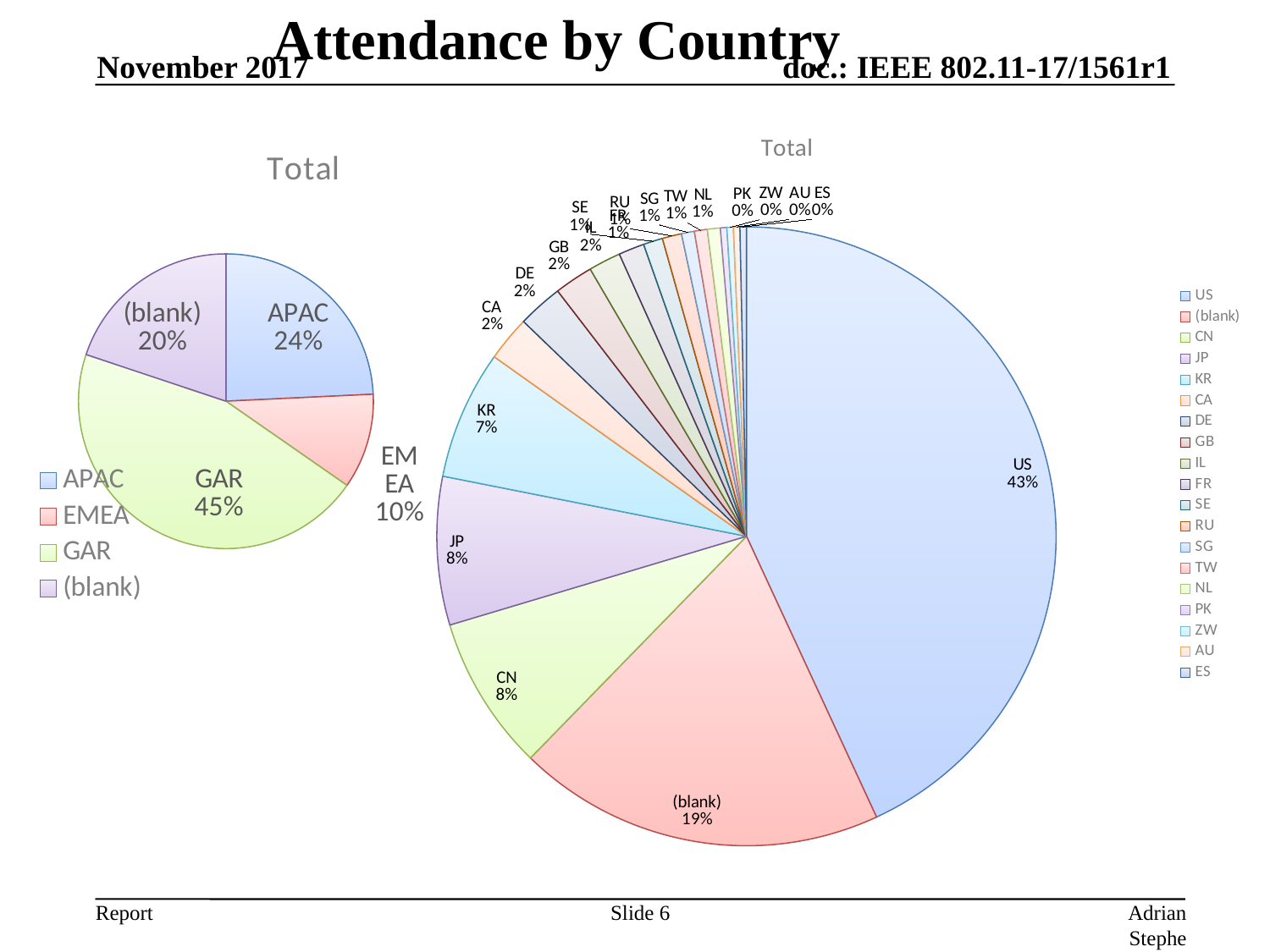
In the pie chart on the right, which is larger, the share for (blank) or the share for JP? (blank) In the pie chart on the right, which country has the largest share? US In the pie chart on the left, what is the difference between the GAR share and the (blank) share? 25% In the pie chart on the left, which region has the smallest share? EMEA In the pie chart on the left, how many slices are there? 4 In the pie chart on the left, which region has the largest share? GAR What kind of chart is the chart on the right? Pie chart In the pie chart on the right, what share does KR have? 7% In the pie chart on the right, what share does US have? 43% In the pie chart on the right, how many entries does the legend list? 19 In the pie chart on the left, what share does APAC have? 24% In the pie chart on the left, what share does GAR have? 45%